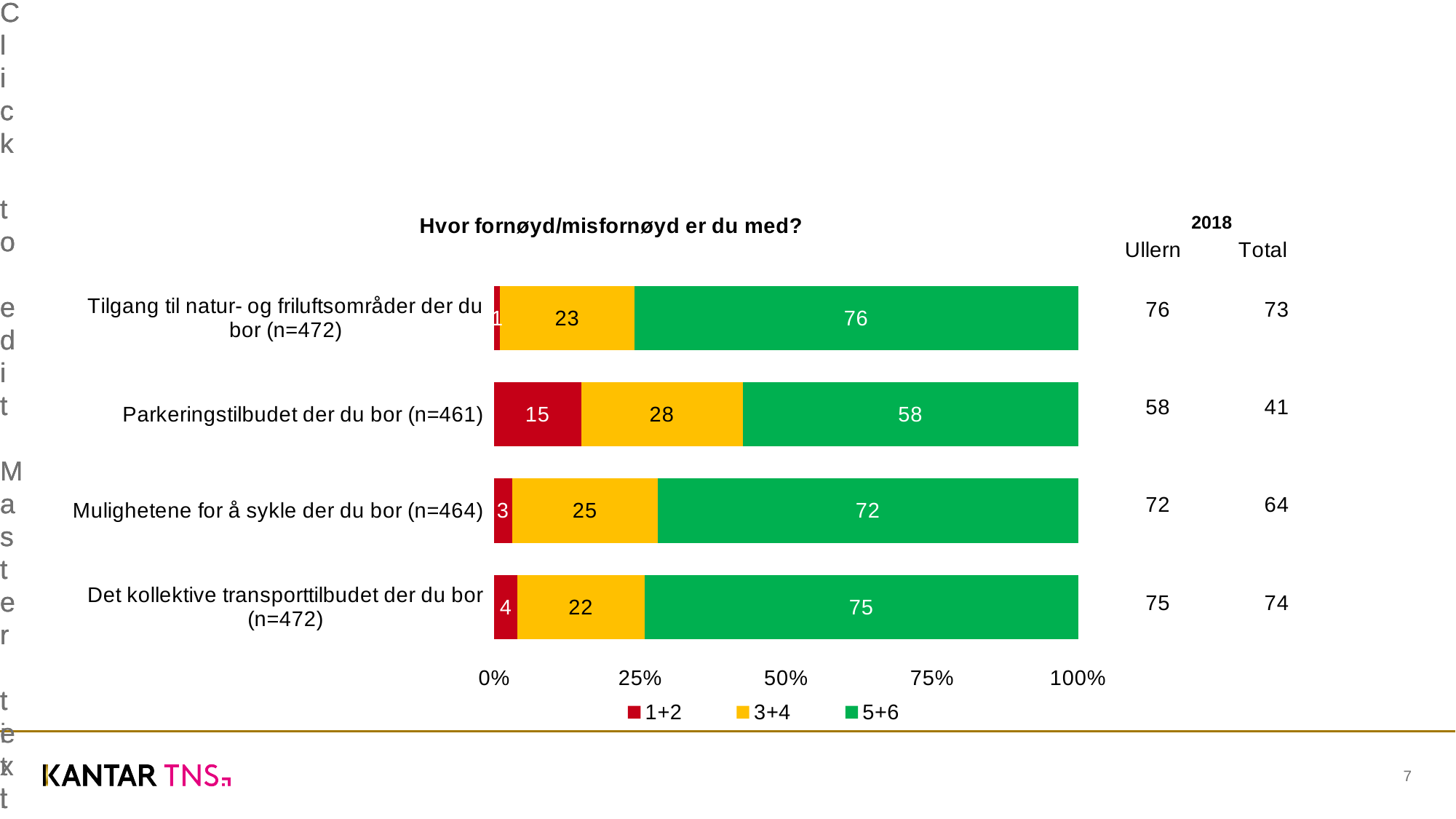
What is the difference between the 5+6 values for "Tilgang til natur- og friluftsområder der du bor (n=472)" and "Parkeringstilbudet der du bor (n=461)"? 18 Which category has the highest 5+6 value? Tilgang til natur- og friluftsområder der du bor (n=472) Which category has the lowest 5+6 value? Parkeringstilbudet der du bor (n=461) What is the 1+2 value for "Det kollektive transporttilbudet der du bor (n=472)"? 4 Which is larger: the 3+4 value for "Parkeringstilbudet der du bor (n=461)" or the 3+4 value for "Det kollektive transporttilbudet der du bor (n=472)"? Parkeringstilbudet der du bor (n=461) How many series does the legend list? 3 What is the 3+4 value for "Mulighetene for å sykle der du bor (n=464)"? 25 How many categories are plotted in the chart? 4 What is the 5+6 value for "Parkeringstilbudet der du bor (n=461)"? 58 What kind of chart is shown on the slide? Stacked bar chart What is the title of the chart? Hvor fornøyd/misfornøyd er du med? Which colour represents the 1+2 series in the legend? Red